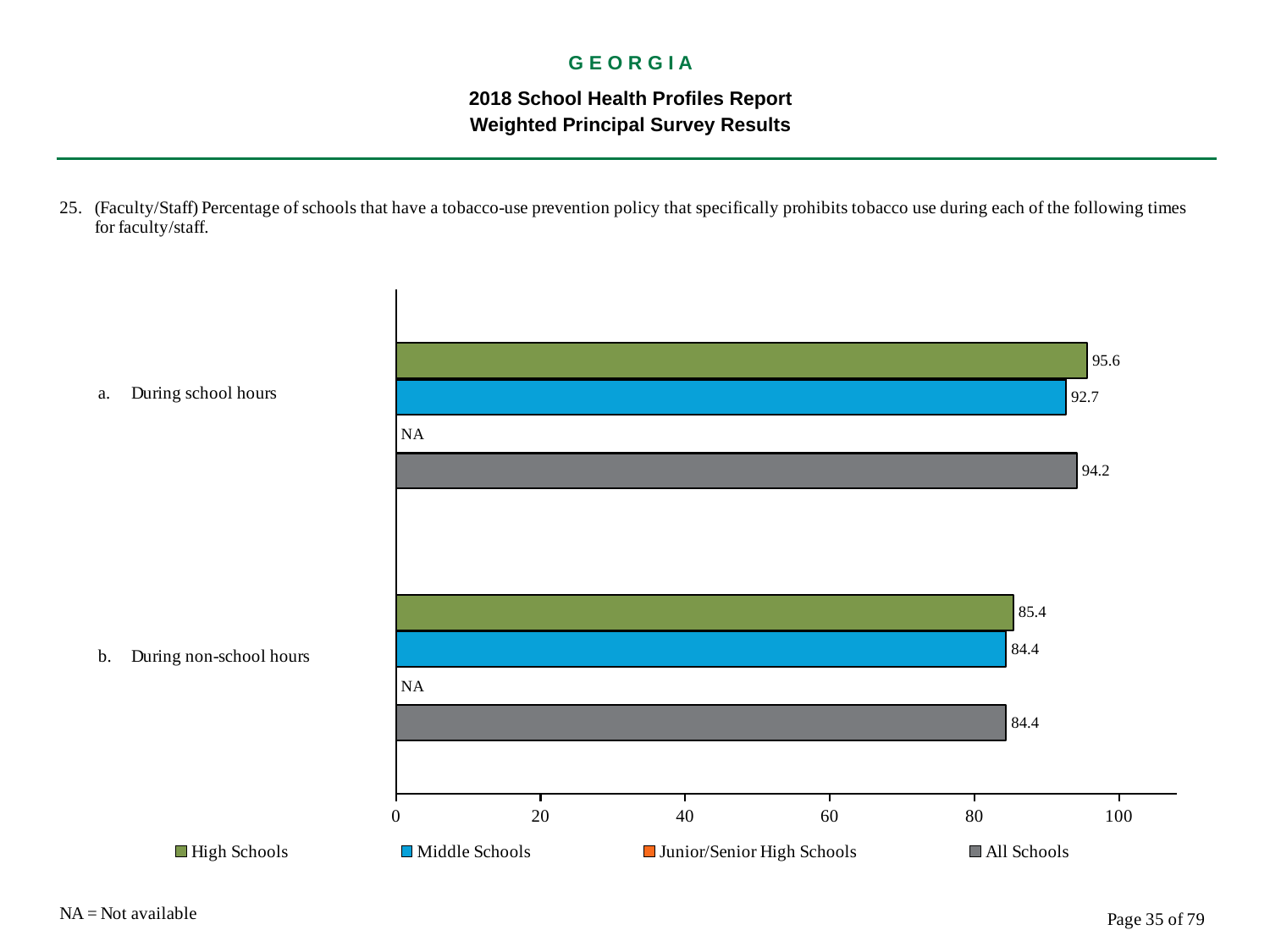
What is the difference between the High Schools values for school hours and non-school hours? 10.2 What colour represents All Schools in the legend? Gray Is the value for All Schools during non-school hours greater or less than 80? greater Which is larger: the Middle Schools value during school hours or during non-school hours? During school hours Which series has the lowest plotted value during school hours? Middle Schools What kind of chart is shown on the slide? Bar chart What is shown for Junior/Senior High Schools during school hours? NA What is the value for High Schools during school hours? 95.6 How many series does the legend list? 4 What is the value for All Schools during school hours? 94.2 What is the value for Middle Schools during non-school hours? 84.4 Which series has the highest value during non-school hours? High Schools